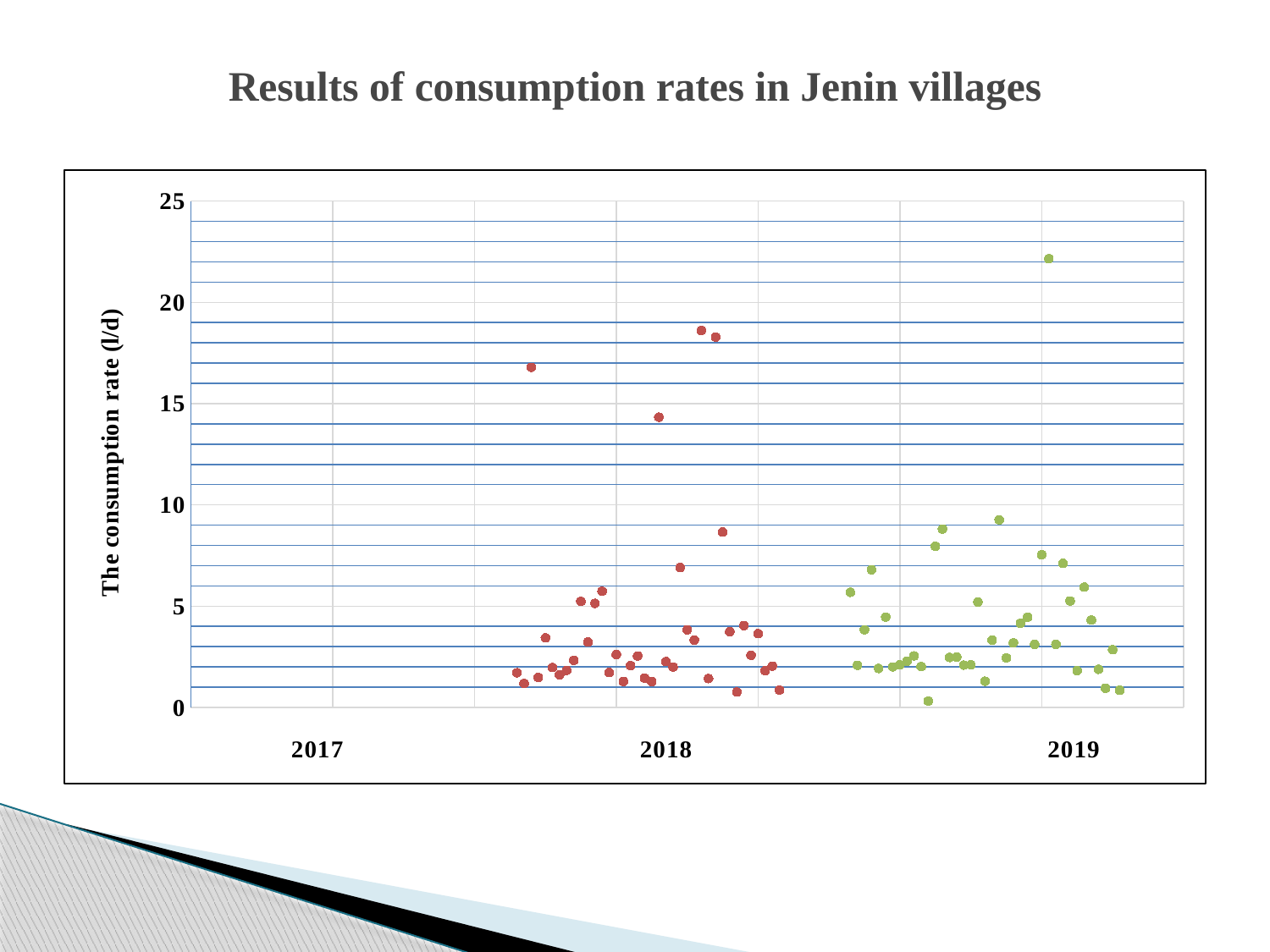
Is the highest red point on the chart greater or less than 20? less Are the green points plotted closer to the 2018 label or the 2019 label on the horizontal axis? 2019 What is the highest value shown on the vertical axis? 25 Is the highest red point on the chart greater or less than 15? greater How many year labels are shown on the horizontal axis? 3 Is the lowest green point on the chart greater or less than 1? less What is the label of the vertical axis? The consumption rate (l/d) Are the red points plotted closer to the 2018 label or the 2019 label on the horizontal axis? 2018 Which colour of points contains the single highest value on the chart, red or green? green What is the title of the chart? Results of consumption rates in Jenin villages What kind of chart is shown on the slide? scatter chart